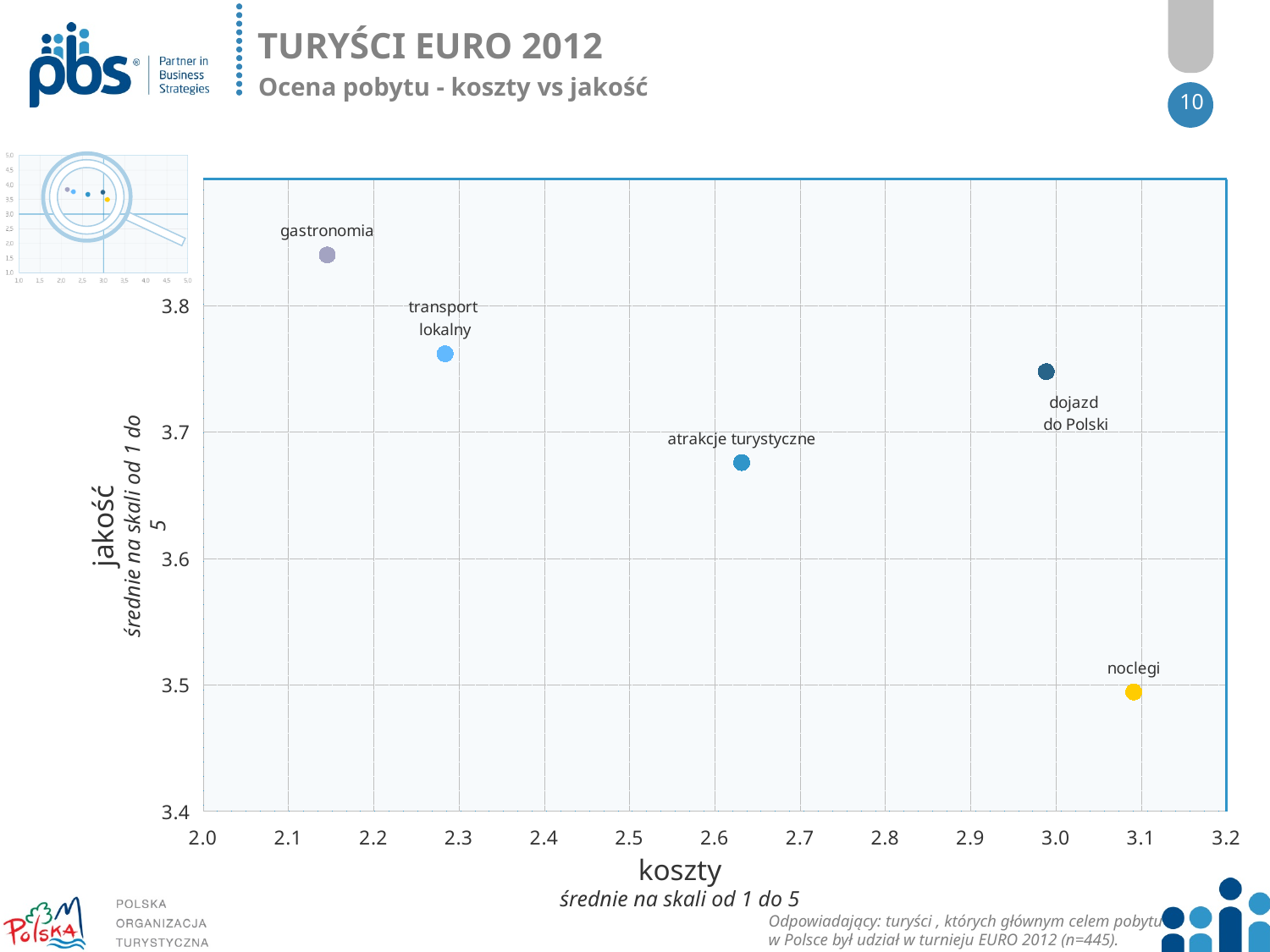
Is the koszty value for noclegi greater or less than 3.0? greater Which category has the highest jakość (quality) value? gastronomia Which category has the highest koszty (cost) value? noclegi Which category has the lowest koszty (cost) value? gastronomia Is the koszty value for transport lokalny greater or less than 2.4? less What is the title of the horizontal axis? koszty Is the jakość value for gastronomia greater or less than 3.8? greater How many data points are plotted on the chart? 5 What kind of chart is shown on the slide? scatter chart Which has the higher koszty value, atrakcje turystyczne or transport lokalny? atrakcje turystyczne Which category has the lowest jakość (quality) value? noclegi